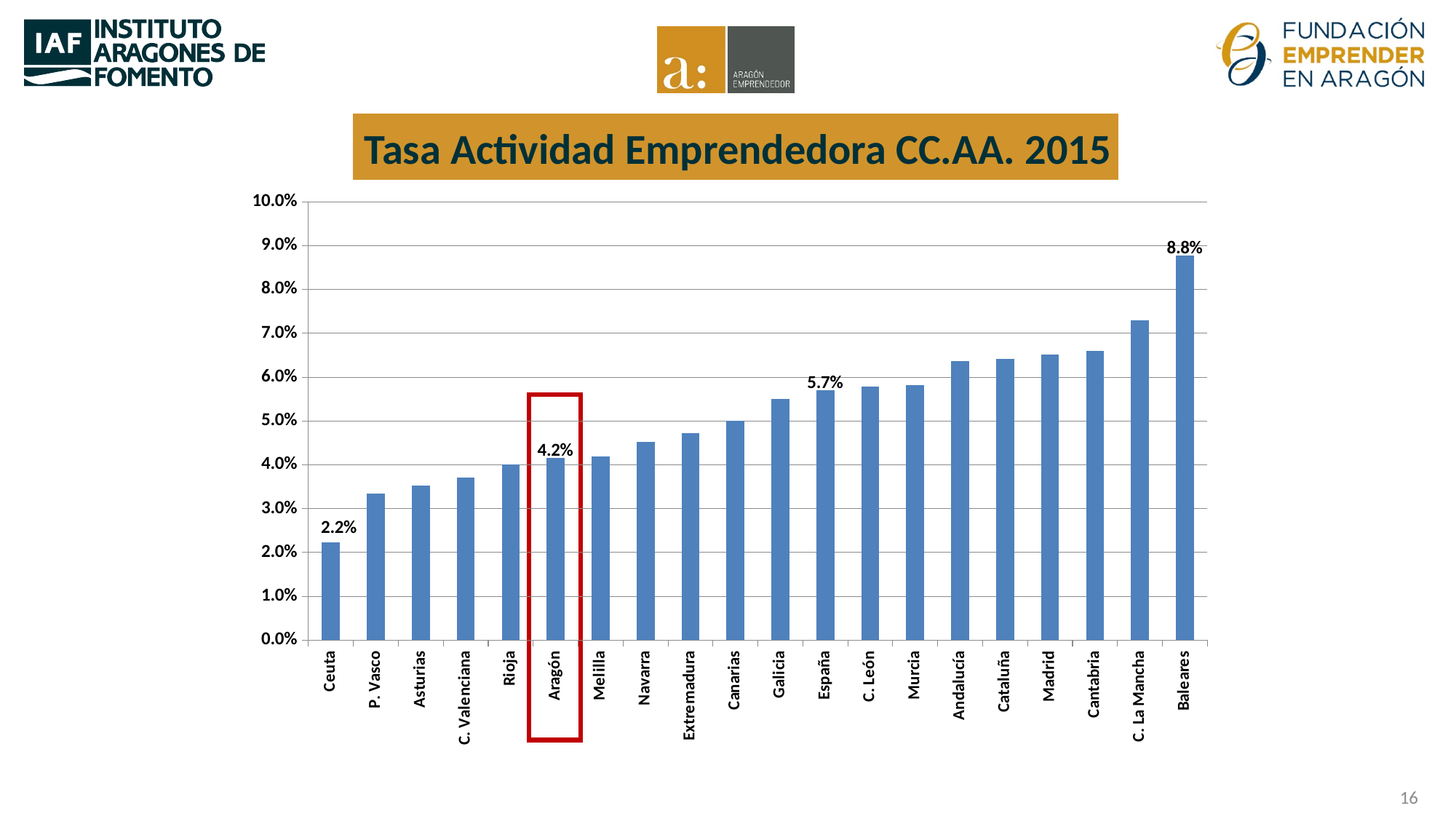
What is the value for España? 5.7% Which region has the lowest value? Ceuta What is the value for Aragón? 4.2% What is the difference between the values for Baleares and Ceuta? 6.6% How many regions are shown on the x axis? 20 Is the value for Madrid greater or less than 6.0%? greater What kind of chart is shown on the slide? Bar chart Which region has the highest value? Baleares What is the value for Ceuta? 2.2% Is the value for C. La Mancha greater or less than 7.0%? greater What is the difference between the values for España and Aragón? 1.5% Which is larger, the value for Aragón or the value for España? España